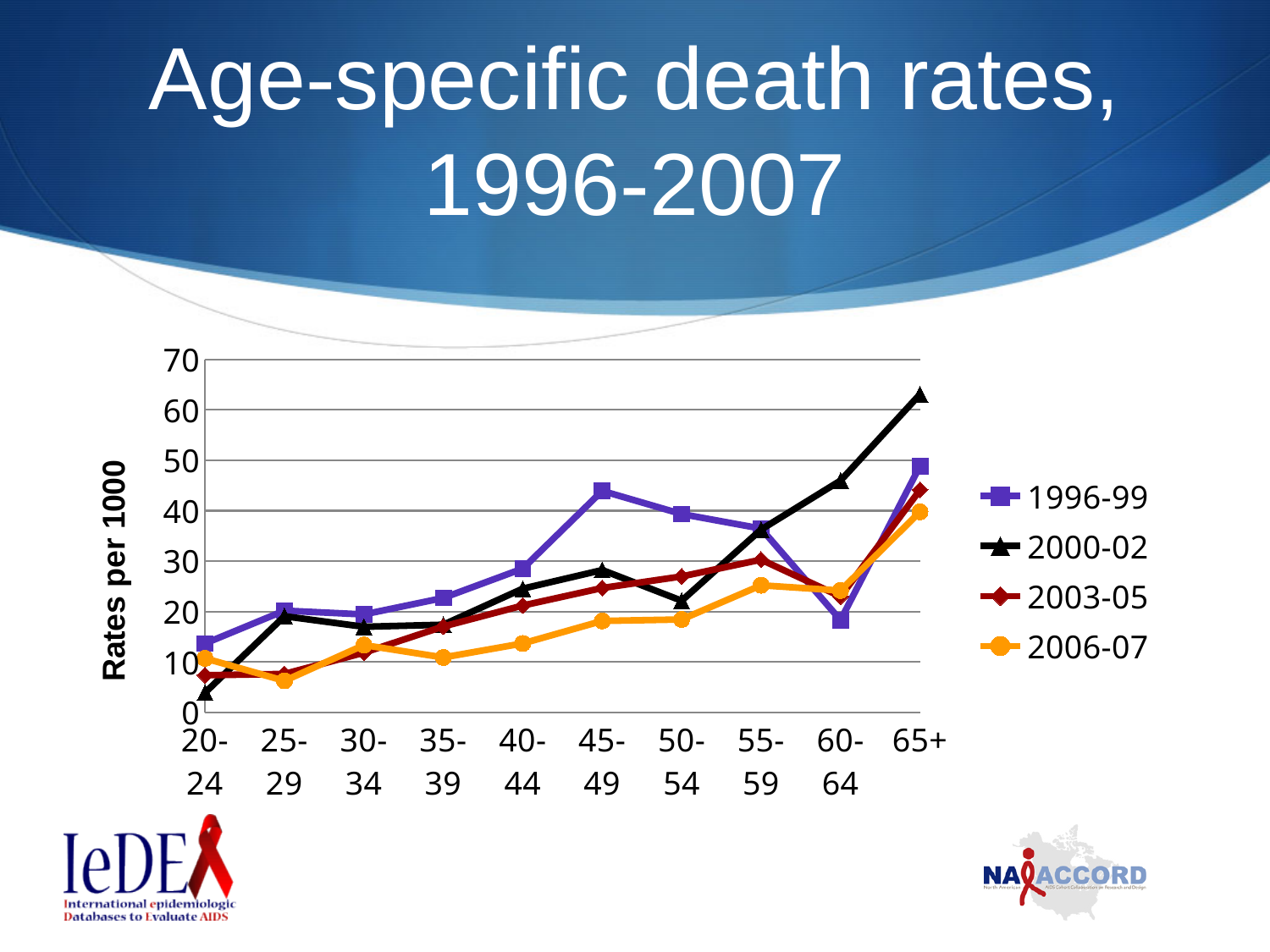
Is the value for the 2006-07 series at 25-29 greater or less than 10? less Is the value for the 2000-02 series at 65+ greater or less than 60? greater For the 2000-02 series, which age group has the lowest death rate? 20-24 Does the 2003-05 series rise or fall from age group 20-24 to 55-59? rise For the 2000-02 series, which age group has the highest death rate? 65+ At age group 45-49, which series has the larger value, 1996-99 or 2006-07? 1996-99 How many age groups are shown along the x axis? 10 What is the label on the vertical axis? Rates per 1000 What kind of chart is shown on the slide? line chart How many series does the legend list? 4 At age group 60-64, which series has the larger value, 1996-99 or 2000-02? 2000-02 Is the value for the 1996-99 series at 45-49 greater or less than 40? greater